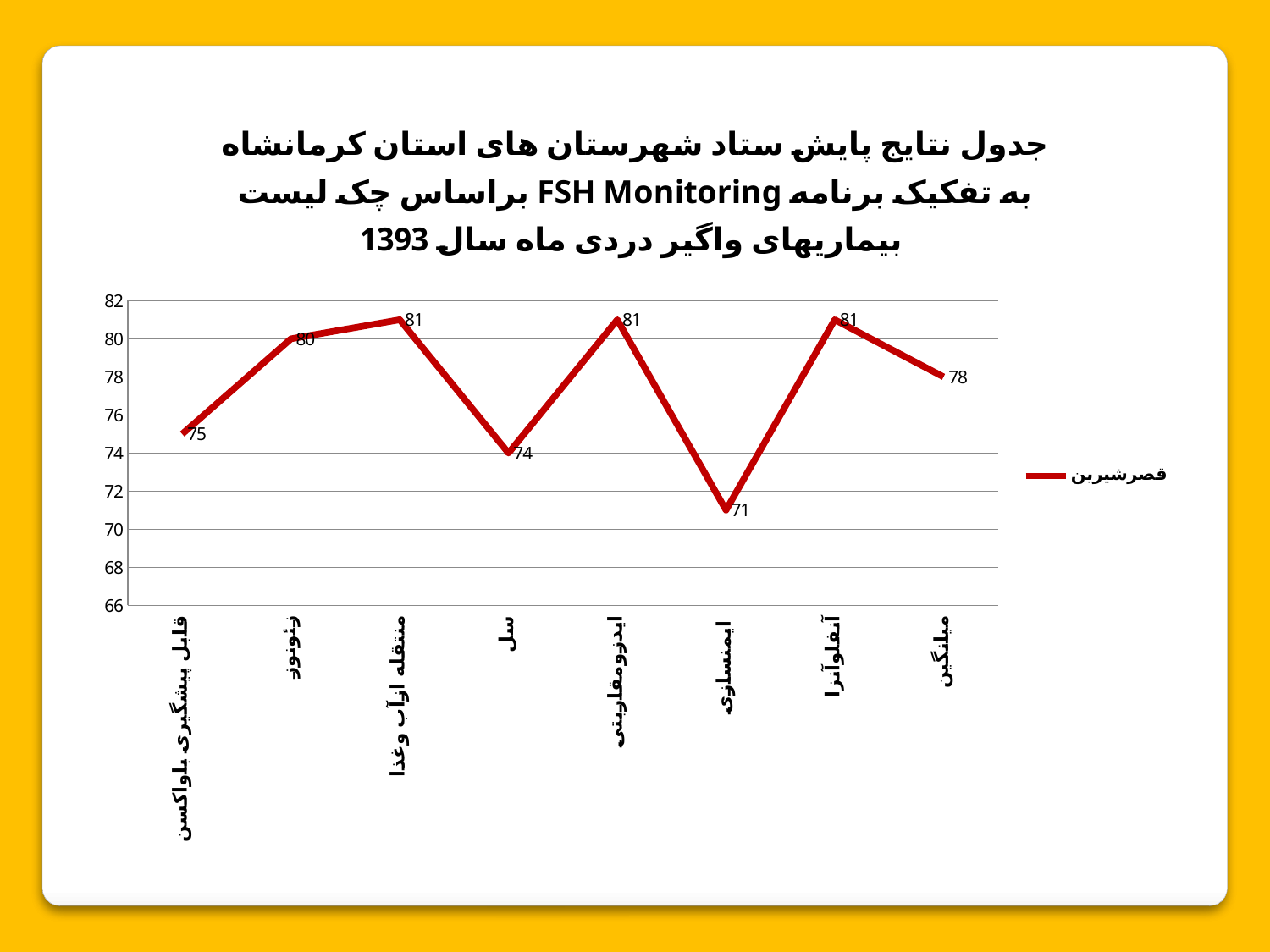
What is the value for قابل پیشگیری با واکسن? 75 Which category has the lowest value? ایمنسازی How many categories are shown on the x axis? 8 What is the difference between the values for آنفلوآنزا and میانگین? 3 What is the name of the series shown in the legend? قصرشیرین What kind of chart is this? line chart What is the value for میانگین? 78 What is the value for سل? 74 Which is larger, the value for زئونوز or the value for سل? زئونوز What is the difference between the values for زئونوز and ایمنسازی? 9 How many series does the legend list? 1 What is the value for ایمنسازی? 71